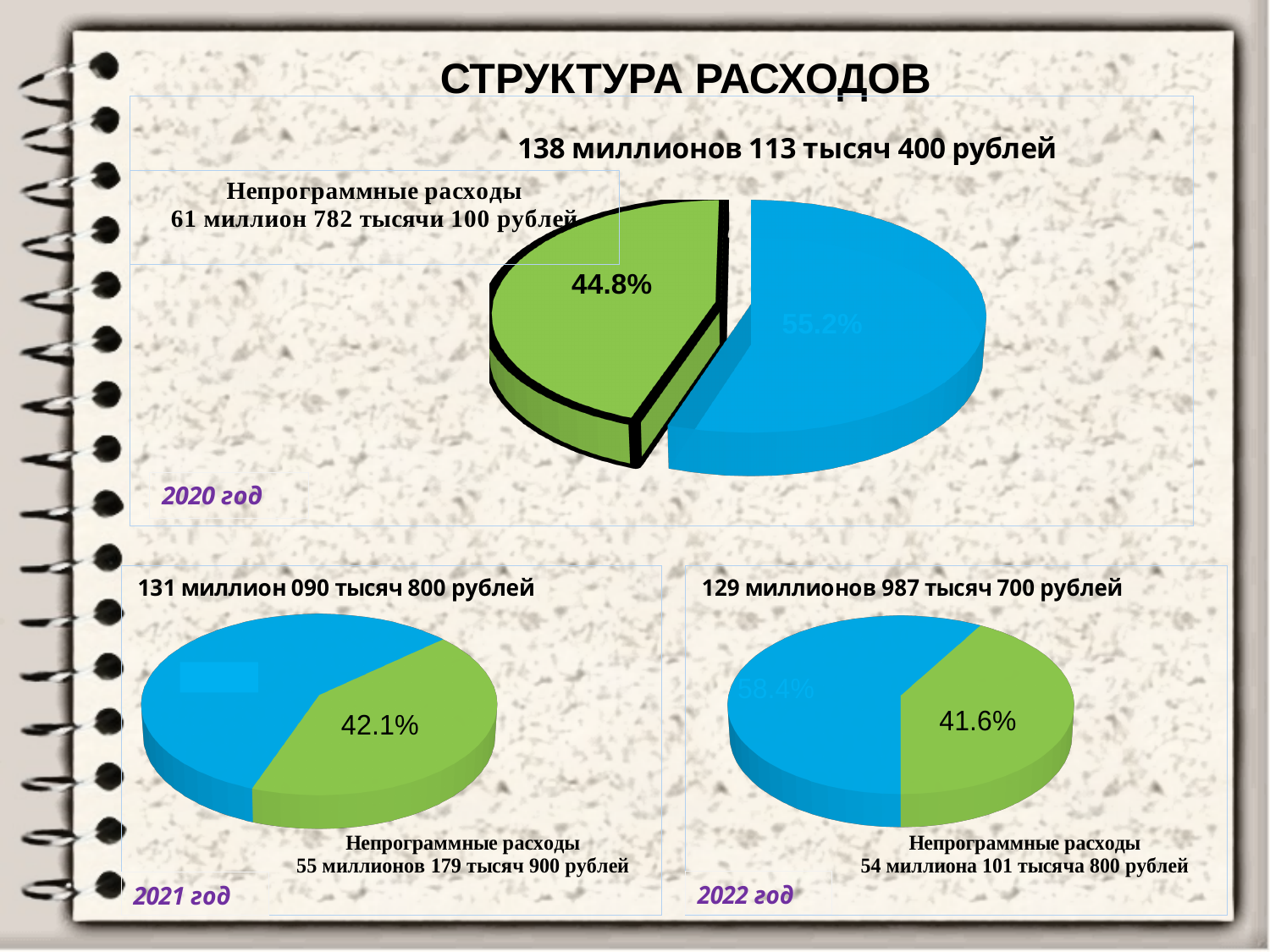
What total amount is shown above the 2022 год pie chart? 129 миллионов 987 тысяч 700 рублей What kind of chart is used for the 2020 год expenditure structure? Pie chart What is the title of the slide containing the three pie charts? СТРУКТУРА РАСХОДОВ In the 2020 год pie chart, what share is labelled on the blue slice? 55.2% What amount of Непрограммные расходы is labelled on the 2021 год pie chart? 55 миллионов 179 тысяч 900 рублей In the 2020 год pie chart, what share is labelled on the green slice? 44.8% How many slices does the 2021 год pie chart have? 2 What total amount is shown above the 2021 год pie chart? 131 миллион 090 тысяч 800 рублей What total amount is shown above the 2020 год pie chart? 138 миллионов 113 тысяч 400 рублей In the 2022 год pie chart, what share is labelled on the green slice? 41.6% In the 2022 год pie chart, which slice is larger, the blue one or the green one? The blue one